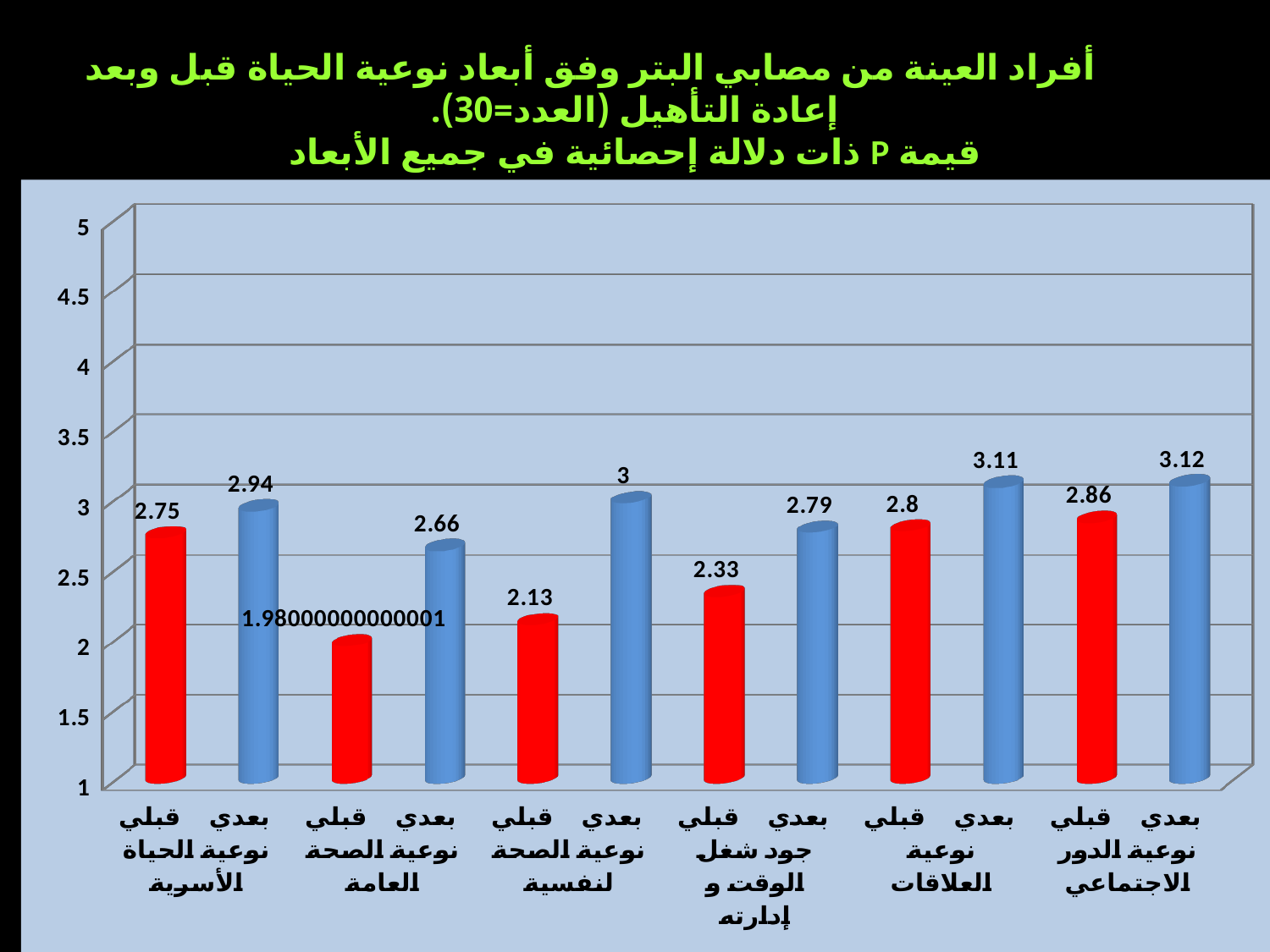
How many bars are plotted in the chart? 12 What is the difference between the بعدي and قبلي values for نوعية الصحة النفسية? 0.87 Which bar has the lowest value in the chart? قبلي نوعية الصحة العامة (1.98000000000001) What is the difference between the بعدي and قبلي values for جودة شغل الوقت وإدارته? 0.46 What is the value of the بعدي (after) bar for نوعية الدور الاجتماعي? 3.12 What is the value of the بعدي (after) bar for نوعية الصحة النفسية? 3 Which is larger: the قبلي value for نوعية العلاقات or the قبلي value for نوعية الدور الاجتماعي? نوعية الدور الاجتماعي (2.86) What colour are the قبلي (before) bars in the chart? Red What value is printed above the قبلي (before) bar for نوعية الصحة العامة? 1.98000000000001 What is the value of the قبلي (before) bar for نوعية الحياة الأسرية? 2.75 What type of chart is shown on the slide? Bar chart Which bar has the highest value in the chart? بعدي نوعية الدور الاجتماعي (3.12)